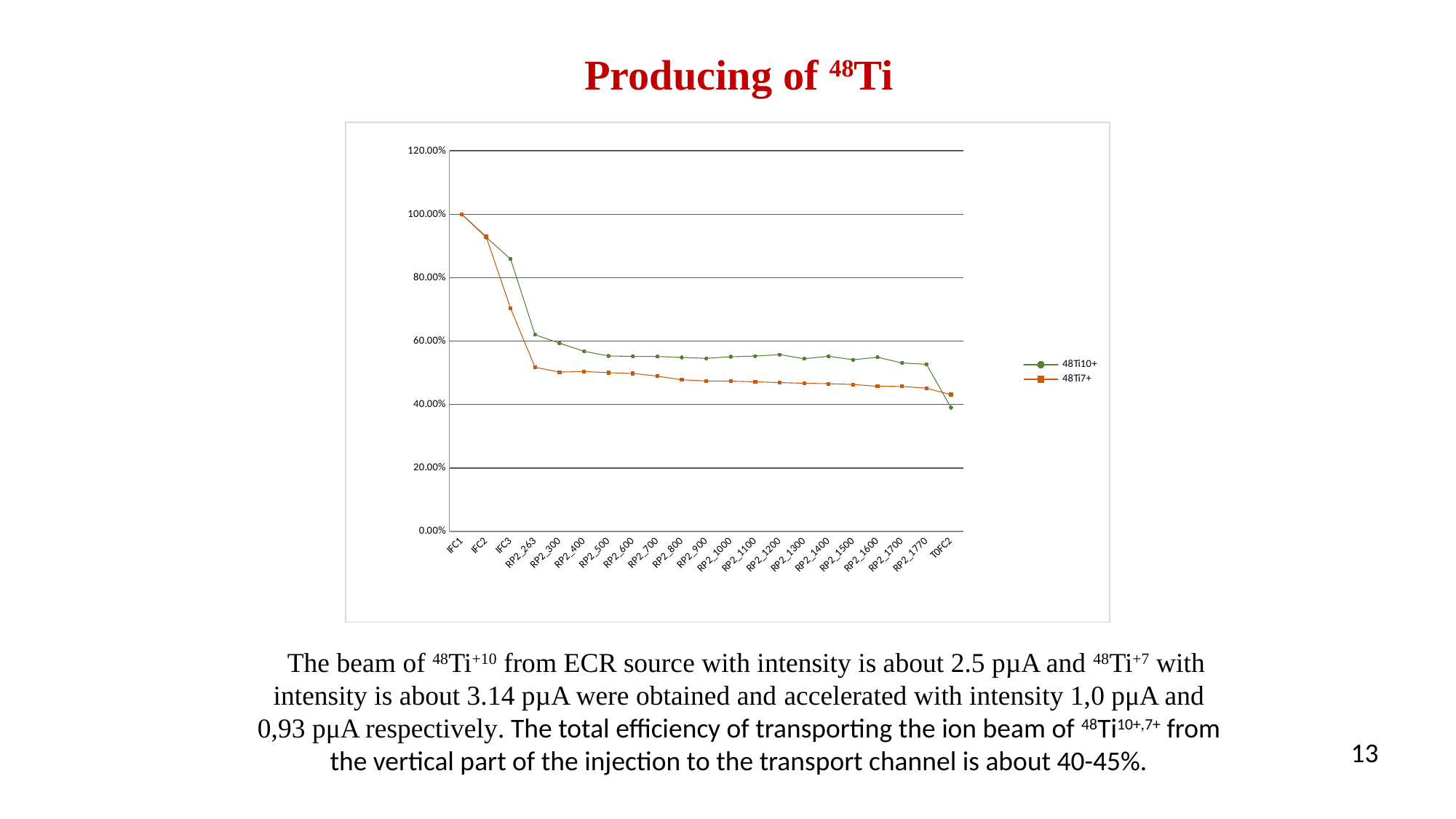
How many categories are plotted along the x axis? 21 Is the value of 48Ti7+ at IFC3 greater or less than 80.00%? less What is the value of the 48Ti7+ series at IFC1? 100.00% What is the value of the 48Ti10+ series at IFC1? 100.00% Do the values of the 48Ti7+ series generally rise or fall from IFC1 to TOFC2? fall At IFC3, which series has the higher value, 48Ti10+ or 48Ti7+? 48Ti10+ Which series is drawn in green? 48Ti10+ Is the value of 48Ti7+ at RP2_263 greater or less than 60.00%? less How many series does the legend list? 2 What kind of chart is shown on the slide? line chart Is the value of 48Ti10+ at IFC3 greater or less than 80.00%? greater